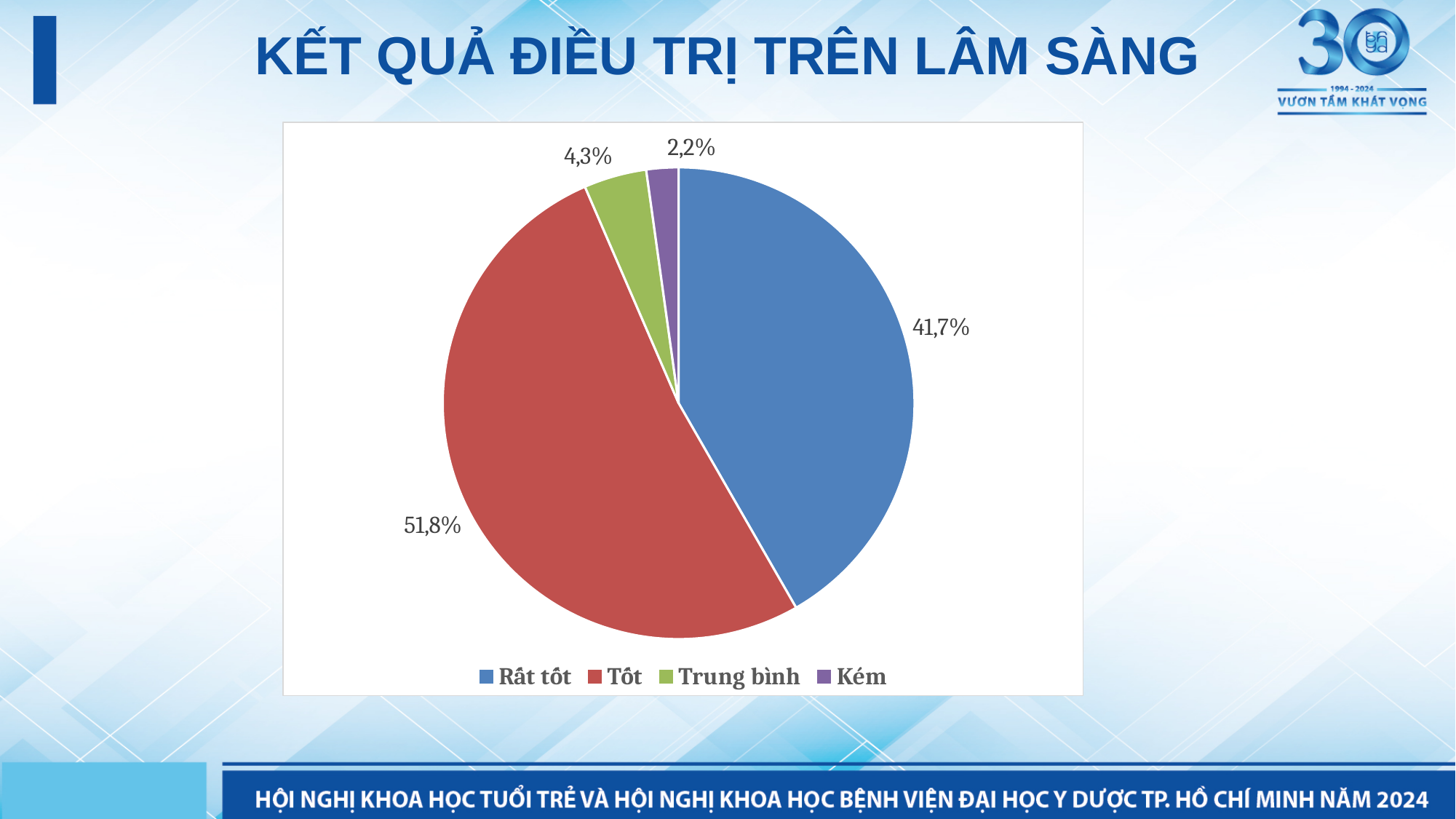
Which is larger, the slice for "Trung bình" or the slice for "Kém"? Trung bình How many categories does the pie chart show? 4 What share of the pie does "Kém" represent? 2,2% What share of the pie does "Rất tốt" represent? 41,7% Which category has the smallest slice of the pie? Kém What share of the pie does "Trung bình" represent? 4,3% What colour is the slice for "Rất tốt"? Blue What kind of chart is shown on the slide? Pie chart What is the difference in percentage points between "Tốt" and "Rất tốt"? 10,1 What is the title of the slide containing the chart? KẾT QUẢ ĐIỀU TRỊ TRÊN LÂM SÀNG Which category has the largest slice of the pie? Tốt